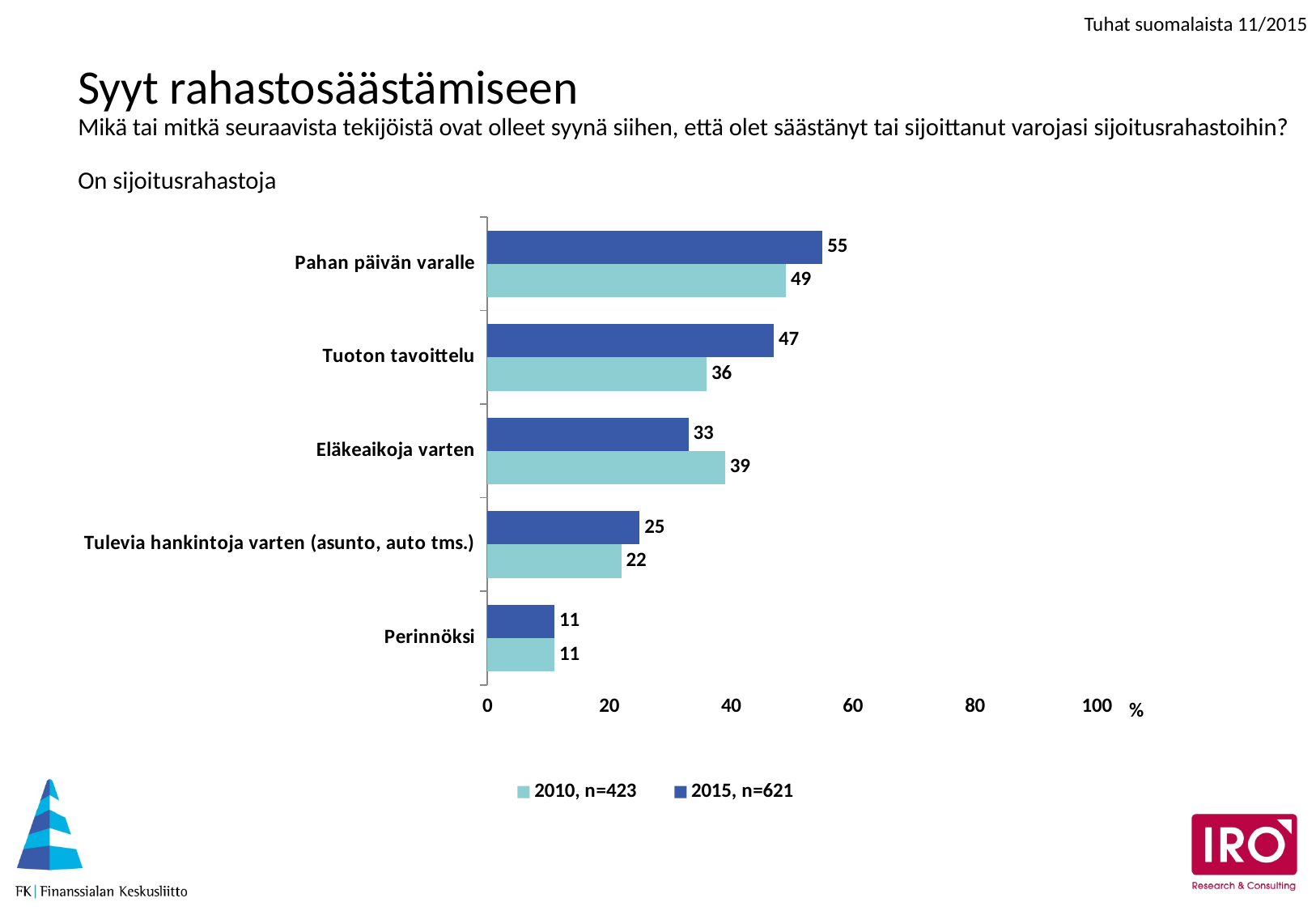
Which category has the lowest value in the 2010, n=423 series? Perinnöksi Is the 2015 value for "Pahan päivän varalle" greater or less than 40? greater How many series does the legend list? 2 What is the difference between the 2015 and 2010 values for "Tuoton tavoittelu"? 11 Which category has the highest value in the 2015, n=621 series? Pahan päivän varalle What kind of chart is shown on the slide? Bar chart What is the value for "Eläkeaikoja varten" in the 2010, n=423 series? 39 What is the value for "Pahan päivän varalle" in the 2015, n=621 series? 55 How many categories are shown on the chart? 5 What is the subtitle shown directly above the chart? On sijoitusrahastoja For "Eläkeaikoja varten", which series has the larger value, 2010 or 2015? 2010, n=423 What is the value for "Tuoton tavoittelu" in the 2010, n=423 series? 36